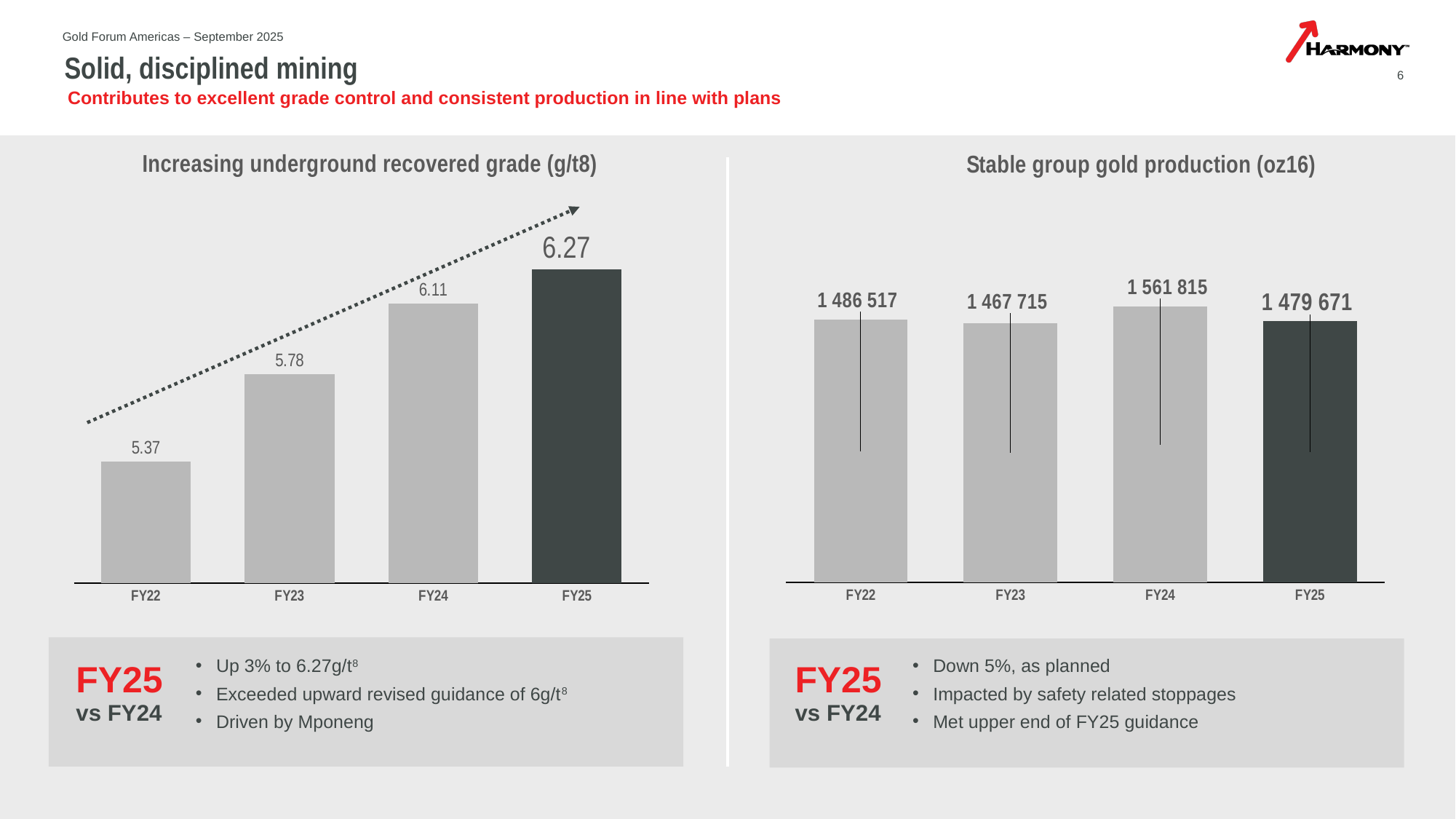
In the 'Stable group gold production (oz16)' chart, what is the value for FY25? 1 479 671 In the 'Increasing underground recovered grade (g/t8)' chart, what is the value for FY25? 6.27 What type of chart is the 'Stable group gold production (oz16)' chart? bar chart In the 'Stable group gold production (oz16)' chart, what is the difference between FY24 and FY25? 82 144 In the 'Stable group gold production (oz16)' chart, which year has the lowest value? FY23 In the 'Increasing underground recovered grade (g/t8)' chart, do the values rise or fall from FY22 to FY25? rise In the 'Stable group gold production (oz16)' chart, which year has the highest value? FY24 In the 'Increasing underground recovered grade (g/t8)' chart, which year has the lowest value? FY22 In the 'Increasing underground recovered grade (g/t8)' chart, what is the value for FY22? 5.37 In the 'Increasing underground recovered grade (g/t8)' chart, what is the difference between FY25 and FY24? 0.16 In the 'Stable group gold production (oz16)' chart, what is the value for FY24? 1 561 815 In the 'Increasing underground recovered grade (g/t8)' chart, how many years are shown? 4